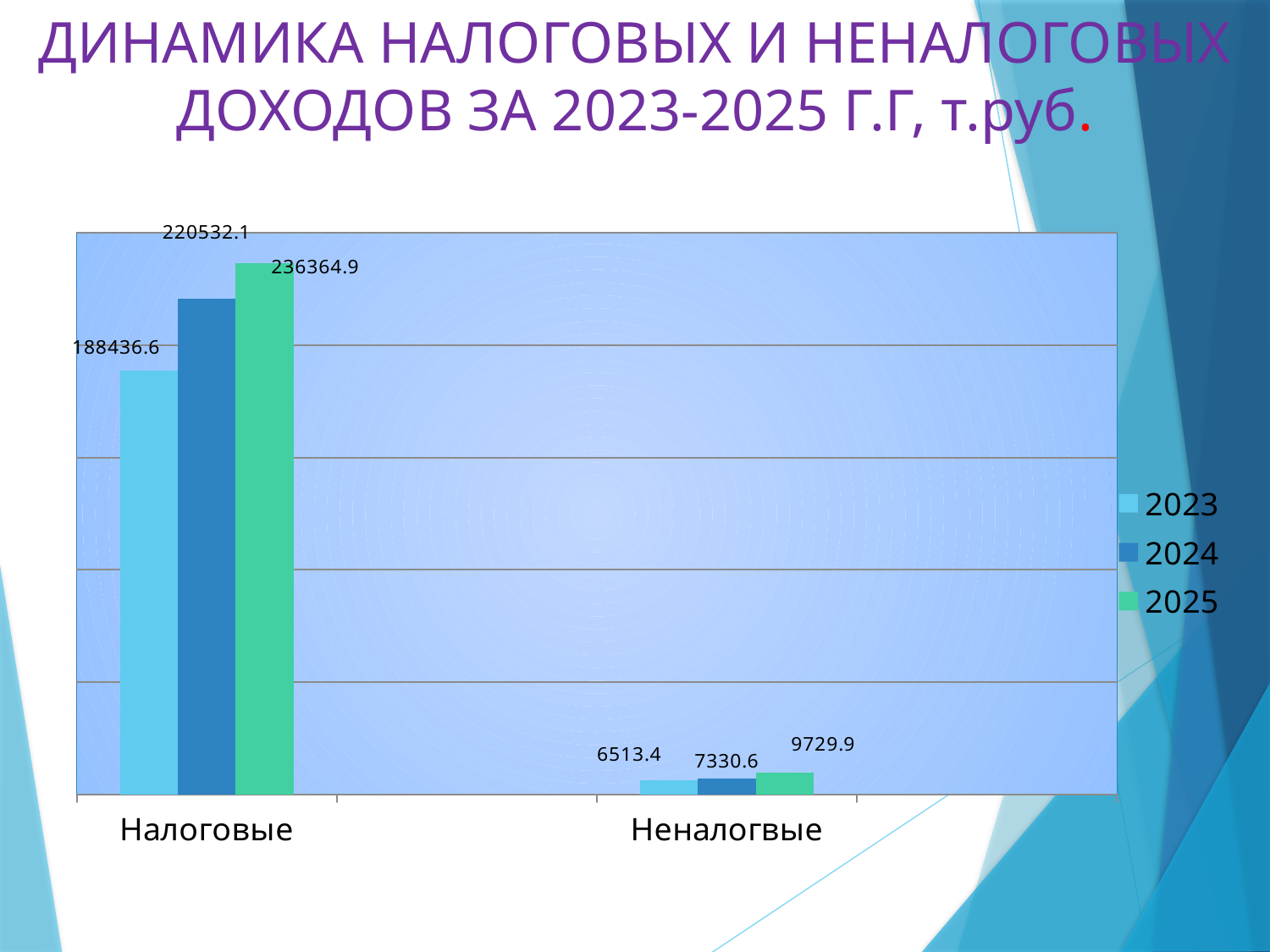
What is the difference between the Налоговые values for 2025 and 2024? 15832.8 Which year has the highest value for Налоговые? 2025 How many series does the legend list? 3 What is the value for Неналогвые in 2025? 9729.9 Which year has the lowest value for Неналогвые? 2023 What is the value for Неналогвые in 2024? 7330.6 What kind of chart is shown on the slide? Bar chart What is the difference between the Неналогвые values for 2025 and 2023? 3216.5 What is the value for Налоговые in 2025? 236364.9 Do the Неналогвые values rise or fall from 2023 to 2025? Rise What is the value for Налоговые in 2023? 188436.6 Which is larger: Налоговые in 2024 or Налоговые in 2023? Налоговые in 2024